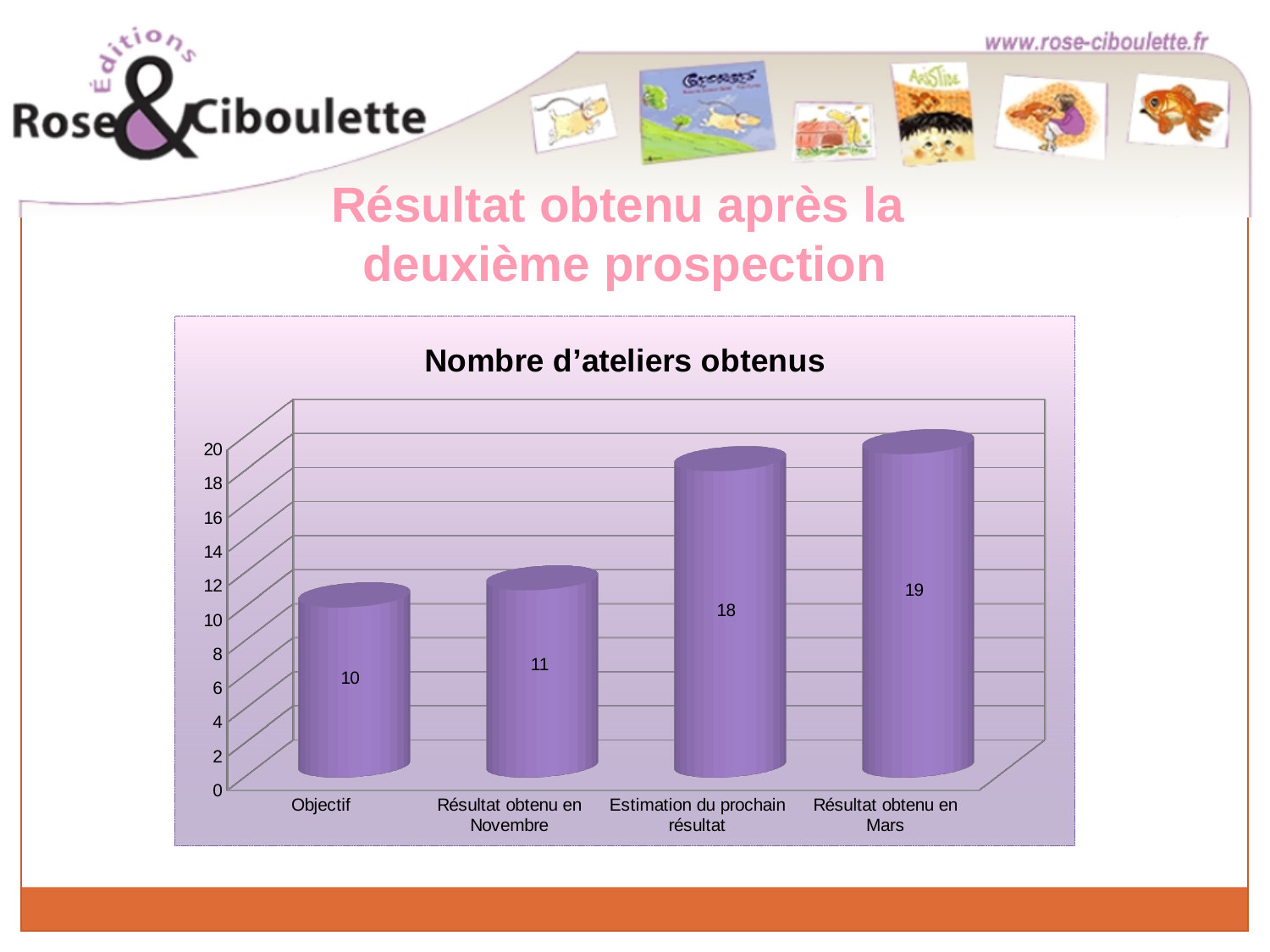
What kind of chart is shown? Bar chart How many categories are shown on the chart? 4 What is the value for Résultat obtenu en Novembre? 11 Which is larger, Résultat obtenu en Novembre or Estimation du prochain résultat? Estimation du prochain résultat What is the title of the chart? Nombre d’ateliers obtenus Which category has the highest value? Résultat obtenu en Mars What is the value for Objectif? 10 What is the difference between Estimation du prochain résultat and Résultat obtenu en Novembre? 7 What is the value for Estimation du prochain résultat? 18 What is the value for Résultat obtenu en Mars? 19 What is the difference between Résultat obtenu en Mars and Objectif? 9 Which category has the lowest value? Objectif